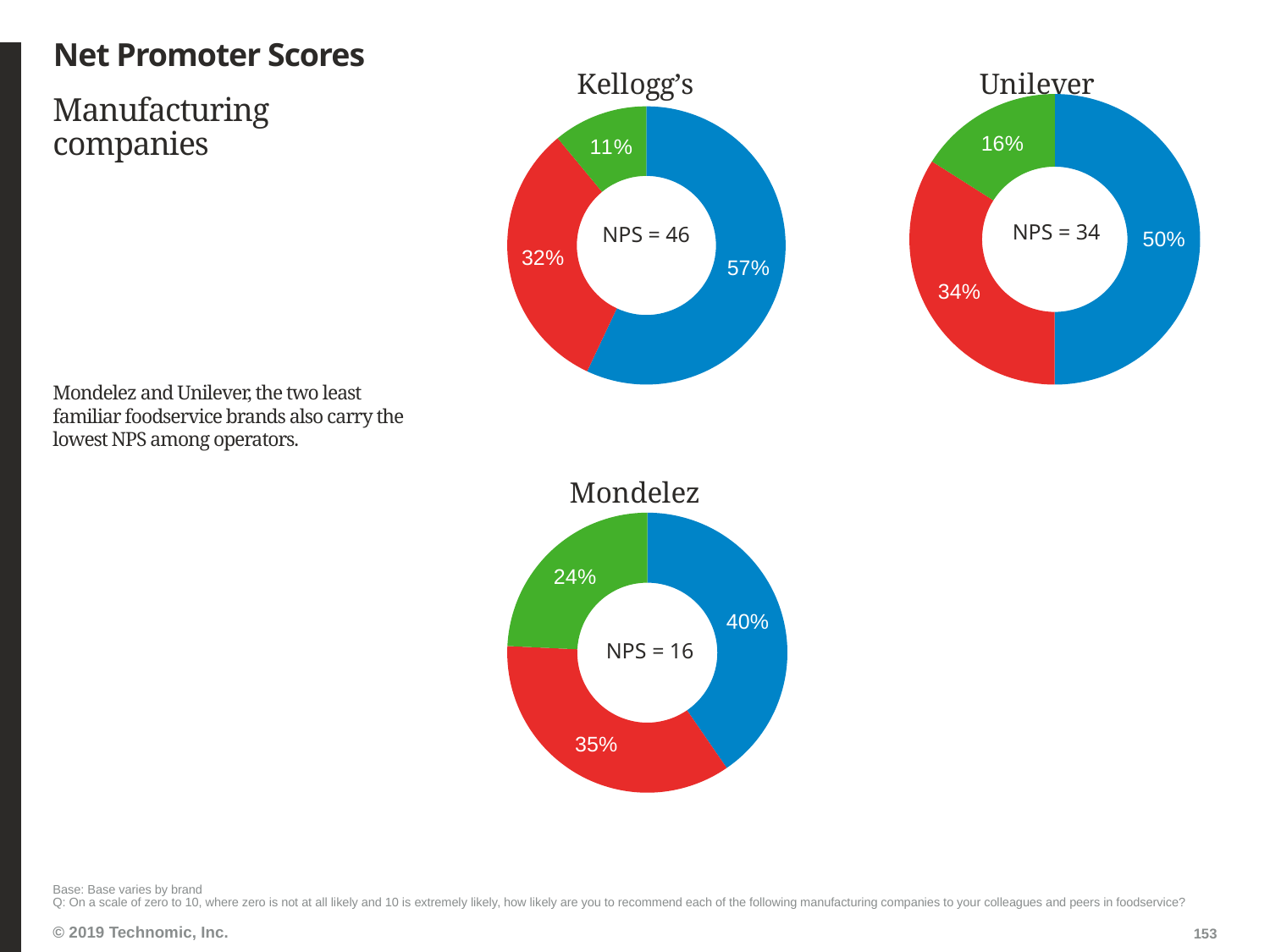
Is the green slice larger in the Unilever chart or in the Mondelez chart? Mondelez In the Mondelez chart, what is the difference between the blue slice and the red slice? 5 percentage points In the Kellogg's chart, what percentage does the blue slice show? 57% In the Unilever chart, what percentage does the red slice show? 34% In the Kellogg's chart, which slice is the largest? The blue slice (57%) How many charts are shown on the slide? 3 How many slices does the Kellogg's chart have? 3 Which of the three charts shows the lowest NPS value? Mondelez What type of chart is used for Kellogg's, Unilever and Mondelez? Donut (pie) chart What NPS value is printed in the centre of the Unilever chart? NPS = 34 Which of the three charts shows the highest NPS value? Kellogg's In the Mondelez chart, what percentage does the green slice show? 24%